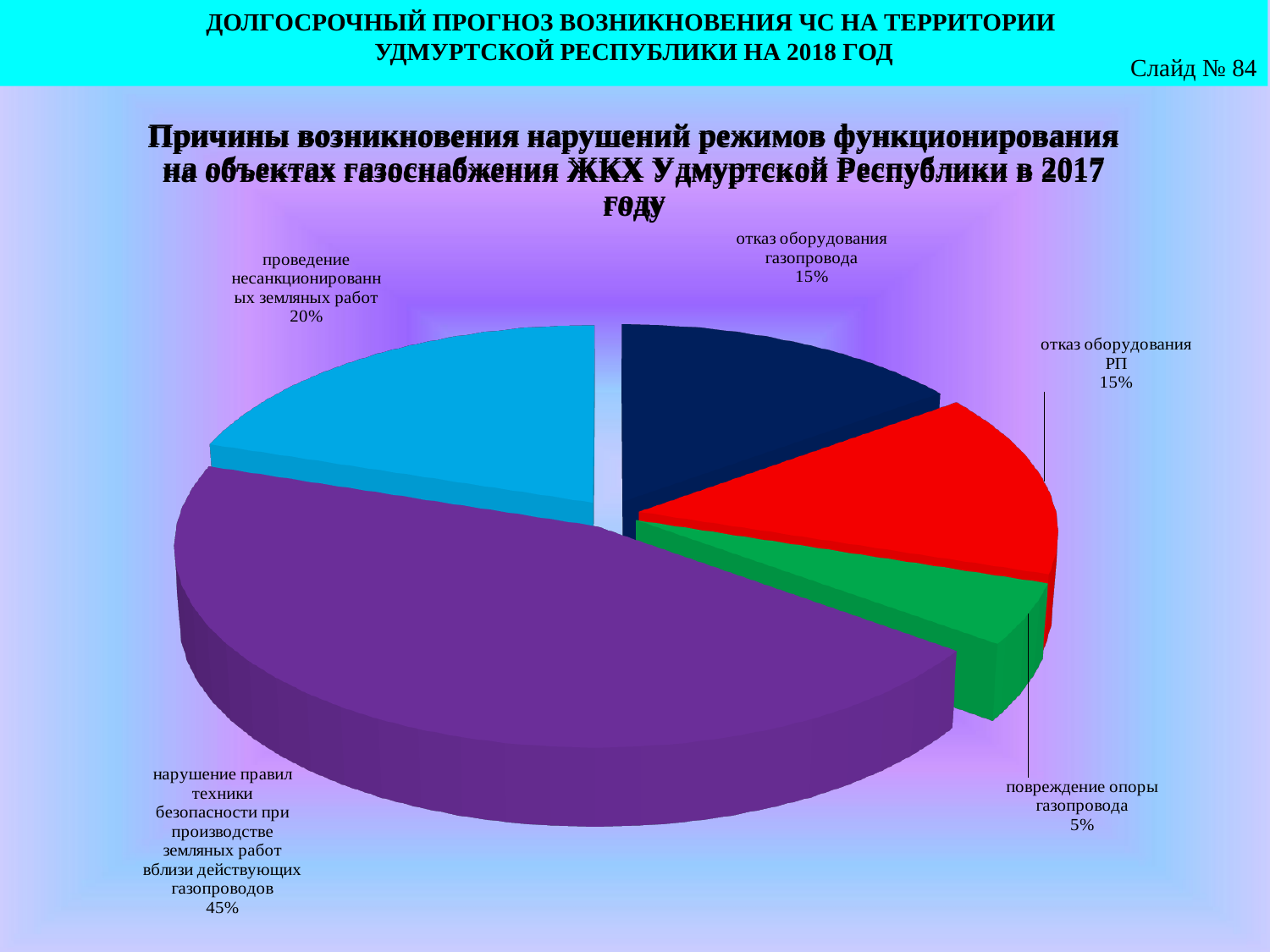
Which year does the chart title say the data refers to? 2017 What kind of chart is shown on the slide? pie chart What share of the pie is labelled "повреждение опоры газопровода"? 5% Which is larger: the share for "проведение несанкционированных земляных работ" or the share for "отказ оборудования газопровода"? проведение несанкционированных земляных работ What share of the pie is labelled "отказ оборудования газопровода"? 15% What share of the pie is labelled "проведение несанкционированных земляных работ"? 20% Which category has the largest share of the pie? нарушение правил техники безопасности при производстве земляных работ вблизи действующих газопроводов Which category has the smallest share of the pie? повреждение опоры газопровода What is the combined share of "отказ оборудования газопровода" and "отказ оборудования РП"? 30% How many slices does the pie chart have? 5 What share of the pie is labelled "отказ оборудования РП"? 15% What is the difference in percentage points between "нарушение правил техники безопасности при производстве земляных работ вблизи действующих газопроводов" and "проведение несанкционированных земляных работ"? 25 percentage points